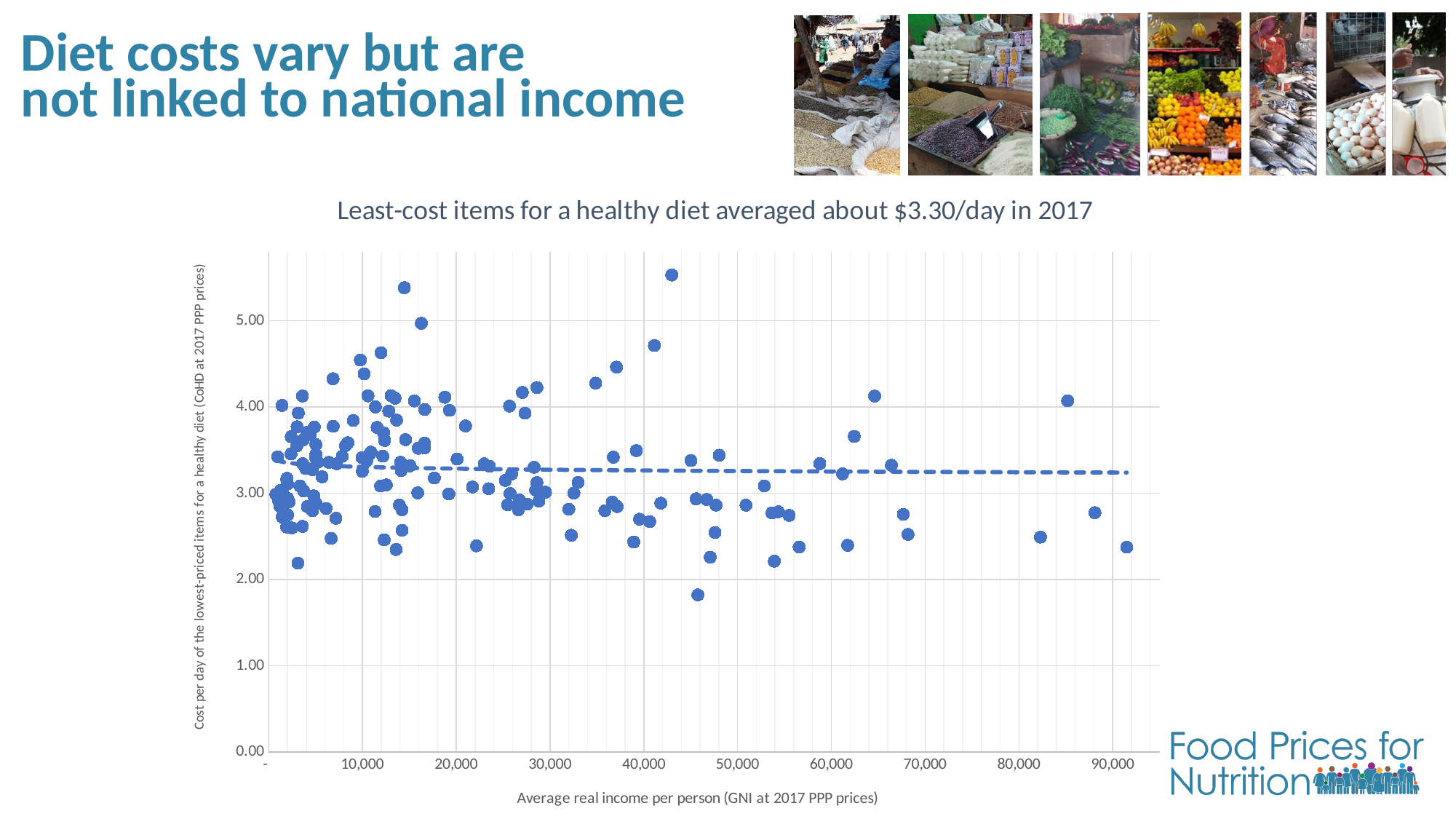
Is the highest point on the chart located below 20,000 income or above 40,000 income? Above 40,000 Are there more plotted points below 10,000 income or above 60,000 income? Below 10,000 What kind of chart is shown on the slide? Scatter chart Is the point plotted at the far right of the chart (around 90,000 income) greater or less than 3.00? less Is the value of the dashed trend line at 90,000 income greater or less than 3.00? greater What is the label of the x axis? Average real income per person (GNI at 2017 PPP prices) Is the highest plotted point on the chart greater or less than 5.00? greater What is the title of the chart? Least-cost items for a healthy diet averaged about $3.30/day in 2017 Does the dashed trend line rise, fall, or stay roughly flat as income increases along the x axis? Roughly flat